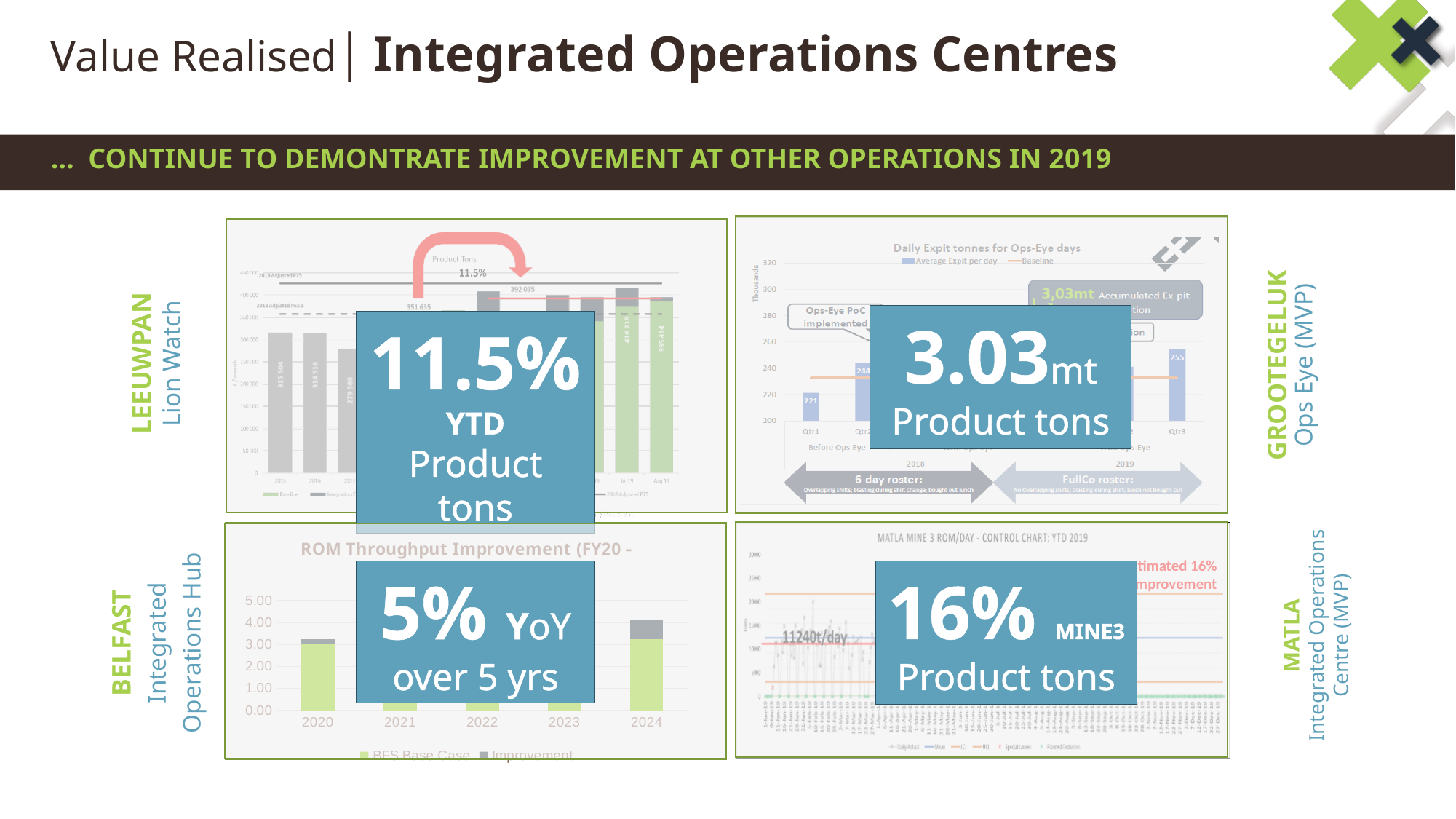
In the bottom-left ROM Throughput Improvement chart, which bar is taller, 2020 or 2024? 2024 In the bottom-left ROM Throughput Improvement chart, is the total value for 2024 greater or less than 3.00? greater How many series does the legend of the bottom-left ROM Throughput Improvement chart list? 2 In the top-right Daily Expit tonnes chart, what is the value labelled on the last Qtr3 bar? 255 What is the title of the bottom-right chart (Matla)? MATLA MINE 3 ROM/DAY - CONTROL CHART: YTD 2019 How many years are shown on the x axis of the bottom-left ROM Throughput Improvement chart? 5 In the bottom-left ROM Throughput Improvement chart, which year has the tallest bar? 2024 What kind of chart is the bottom-left chart (ROM Throughput Improvement, Belfast)? bar chart In the top-right Daily Expit tonnes chart, what is the value labelled on the first Qtr1 bar? 221 In the top-right Daily Expit tonnes chart, which is larger, the first Qtr1 bar (221) or the last Qtr3 bar (255)? Qtr3 (255) What is the title of the top-right chart (Grootegeluk)? Daily Expit tonnes for Ops-Eye days